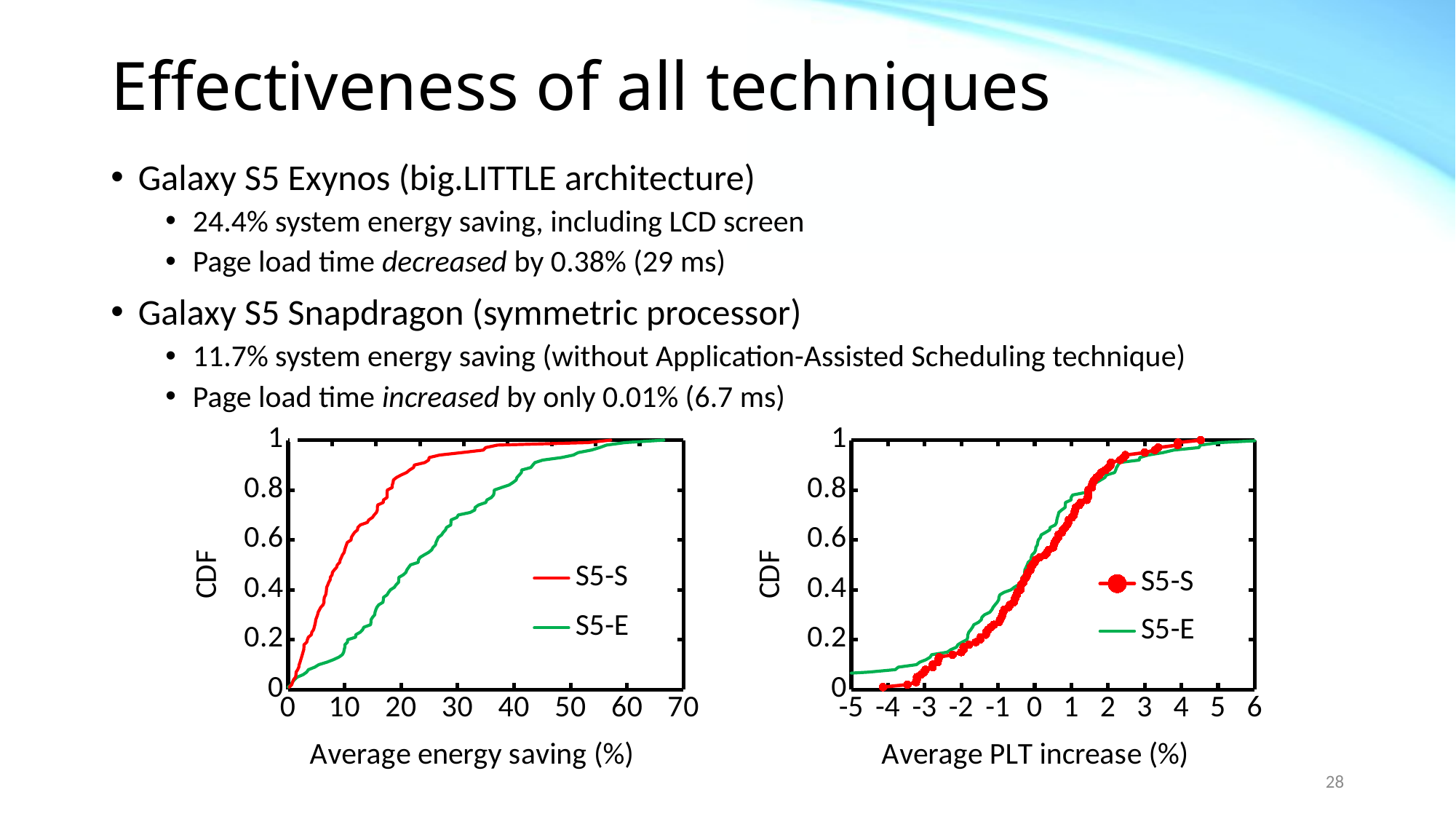
What kind of chart is the left chart (Average energy saving)? line chart In the left chart (Average energy saving), at 20% energy saving, which series has the higher CDF value, S5-S or S5-E? S5-S In the left chart (Average energy saving), is the CDF value for S5-S at 20% energy saving greater or less than 0.8? greater In the left chart (Average energy saving), is the CDF value for S5-S at 10% energy saving greater or less than 0.4? greater In the left chart (Average energy saving), what are the two series named in the legend? S5-S and S5-E What is the x-axis label of the right chart? Average PLT increase (%) In the right chart (Average PLT increase), at -2% PLT increase, which series has the higher CDF value, S5-S or S5-E? S5-E In the right chart (Average PLT increase), is the CDF value for S5-E at -3% PLT increase greater or less than 0.2? less How many series does the legend of the right chart (Average PLT increase) list? 2 In the left chart (Average energy saving), does the CDF for S5-E rise or fall as energy saving increases along the x axis? rise